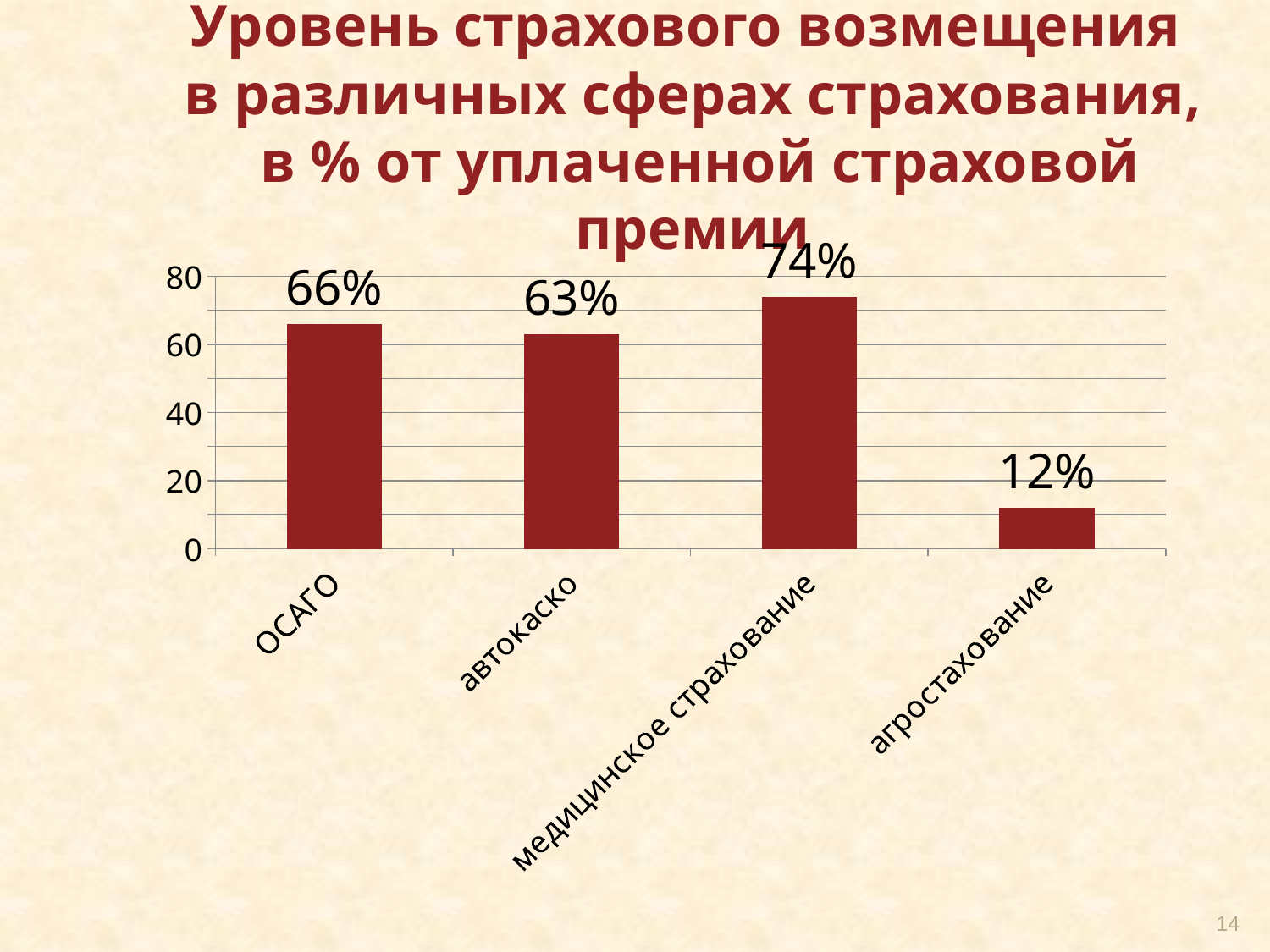
What is the value for автокаско? 63% What is the value for ОСАГО? 66% What is the difference between the values for ОСАГО and автокаско? 3% What is the value for агрострахование? 12% Which category has the lowest value? агрострахование What kind of chart is shown on the slide? bar chart What is the difference between the values for медицинское страхование and агрострахование? 62% Which category has the highest value? медицинское страхование What is the value for медицинское страхование? 74% Is the value for автокаско greater or less than 40? greater Which is larger, the value for ОСАГО or the value for агрострахование? ОСАГО How many categories are shown in the chart? 4